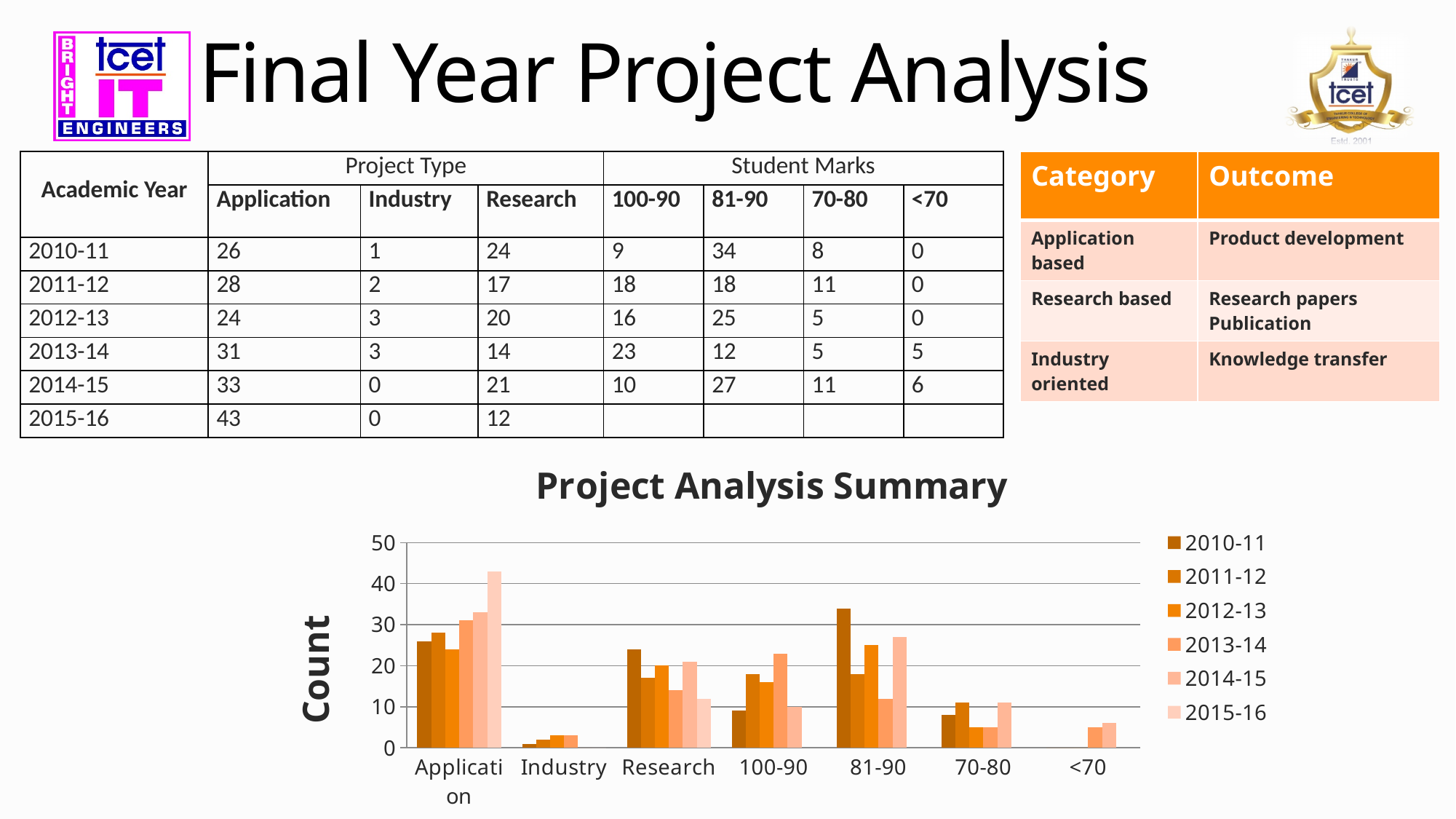
In the Project Analysis Summary chart, which academic year has the highest bar for Application? 2015-16 How many categories are shown on the x axis of the Project Analysis Summary chart? 7 In the Project Analysis Summary chart, which academic year has the lowest bar for the 81-90 category? 2013-14 How many series does the legend of the Project Analysis Summary chart list? 6 According to the slide, what is the Research count for 2014-15? 21 What is the difference between the Application counts for 2015-16 and 2010-11 shown on the slide? 17 What is the label on the vertical axis of the Project Analysis Summary chart? Count In the Project Analysis Summary chart, is the value for 2010-11 in the 81-90 category greater or less than 30? greater In the Project Analysis Summary chart, is the value for 2015-16 in the Application category greater or less than 40? greater In the Project Analysis Summary chart, which is larger for the 81-90 category: 2010-11 or 2011-12? 2010-11 What is the title of the chart on the slide? Project Analysis Summary What kind of chart is the Project Analysis Summary? bar chart